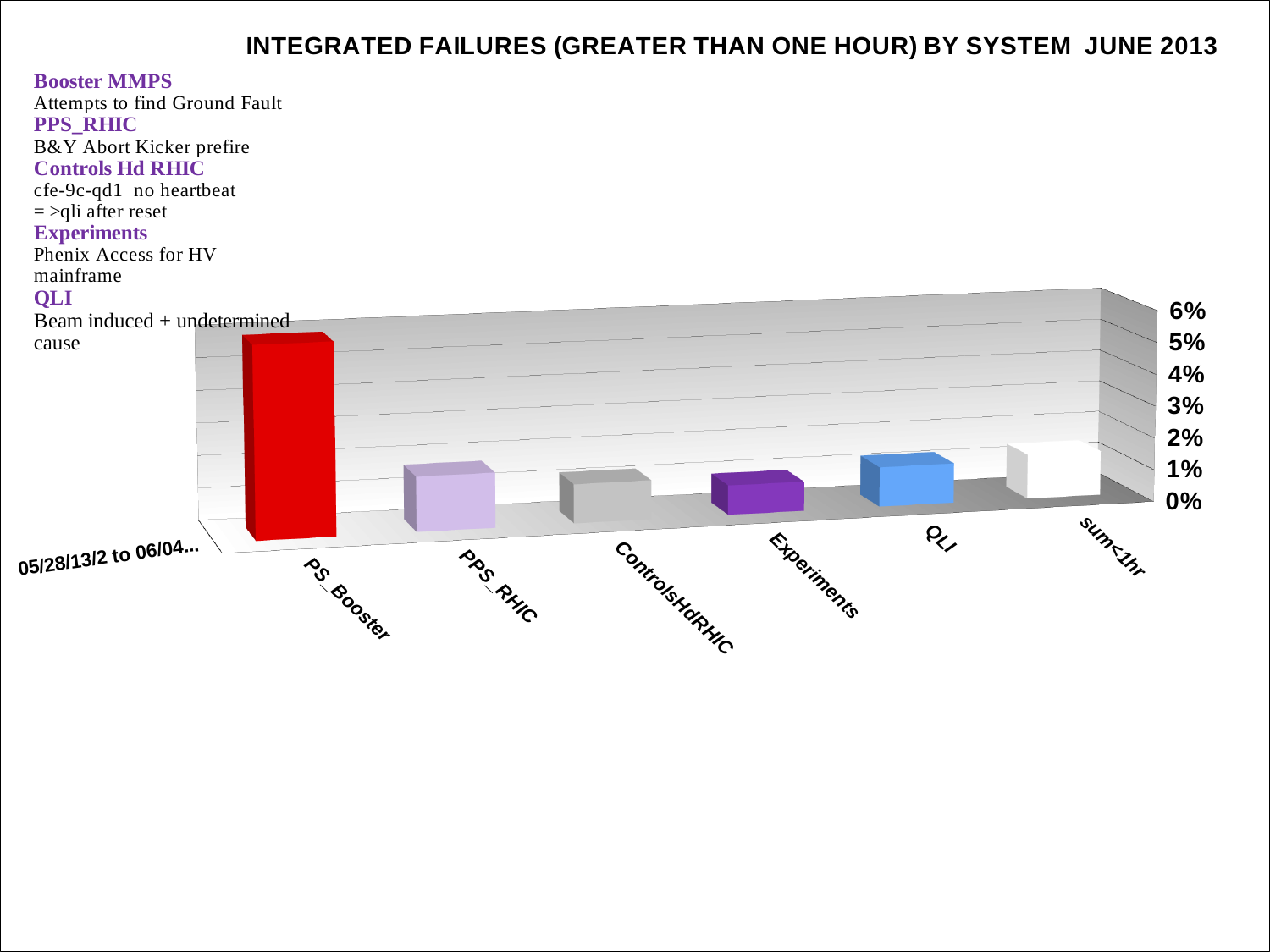
Is the value for Experiments greater or less than 2%? less How many categories are plotted along the x axis of the chart? 6 Is the value for PS_Booster greater or less than 3%? greater Which is larger, the value for PS_Booster or the value for ControlsHdRHIC? PS_Booster Is the value for QLI greater or less than 2%? less Which is larger, the value for PS_Booster or the value for sum<1hr? PS_Booster What is the highest value shown on the vertical axis of the chart? 6% What is the title of the chart? INTEGRATED FAILURES (GREATER THAN ONE HOUR) BY SYSTEM JUNE 2013 What kind of chart is shown on the slide? bar chart Which category has the highest value in the chart? PS_Booster